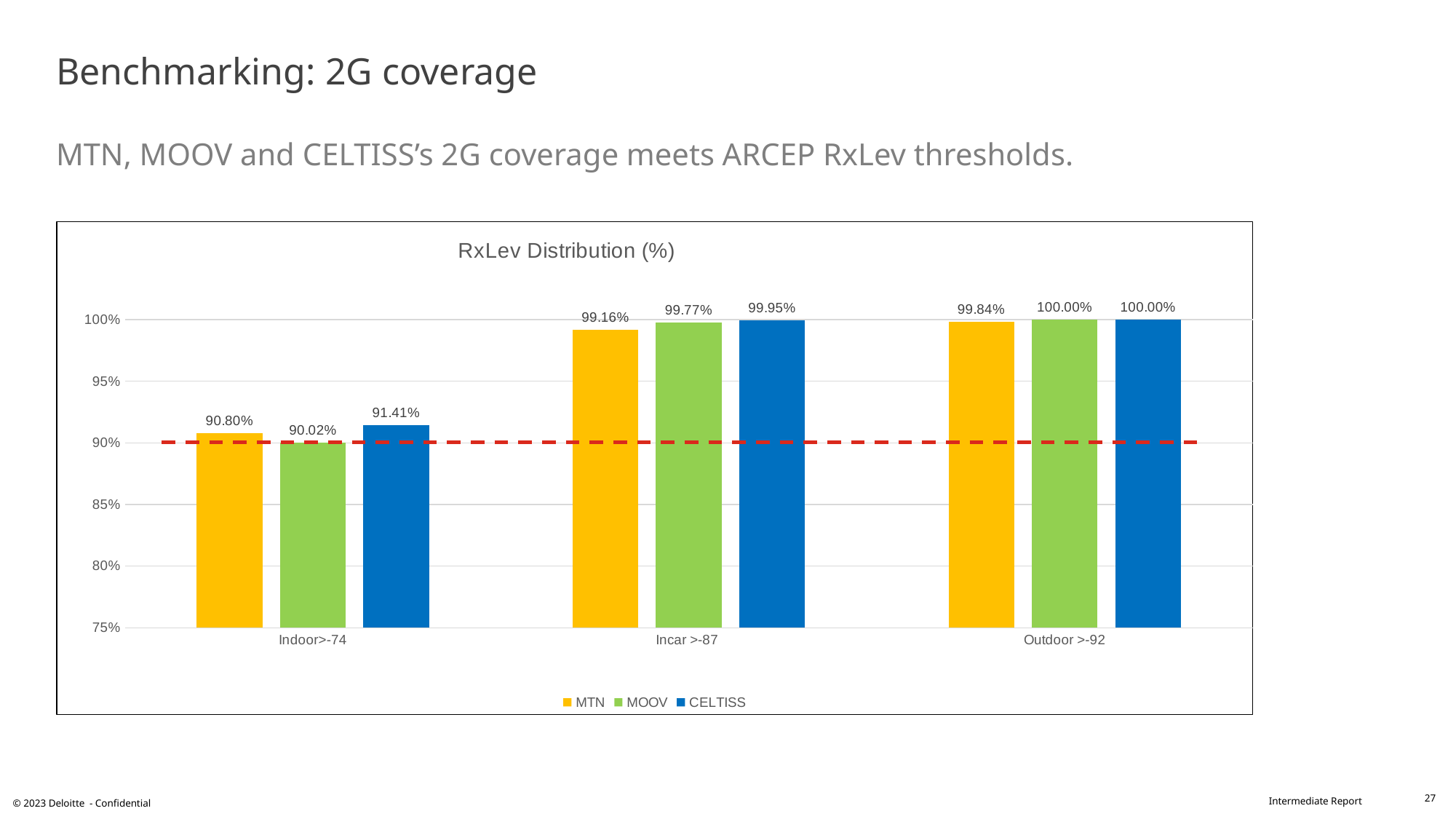
Which operator has the lowest value in the Indoor>-74 category? MOOV How many series does the legend list? 3 Which is larger in the Incar >-87 category, MTN or CELTISS? CELTISS How many categories are shown on the x axis? 3 Is the value for MOOV in the Indoor>-74 category greater or less than 95%? less What is the title of the chart? RxLev Distribution (%) What is the value for MTN in the Indoor>-74 category? 90.80% What is the value for CELTISS in the Outdoor >-92 category? 100.00% What is the difference between CELTISS and MOOV in the Indoor>-74 category? 1.39% What kind of chart is shown on the slide? bar chart Which operator has the highest value in the Indoor>-74 category? CELTISS What is the value for MOOV in the Incar >-87 category? 99.77%